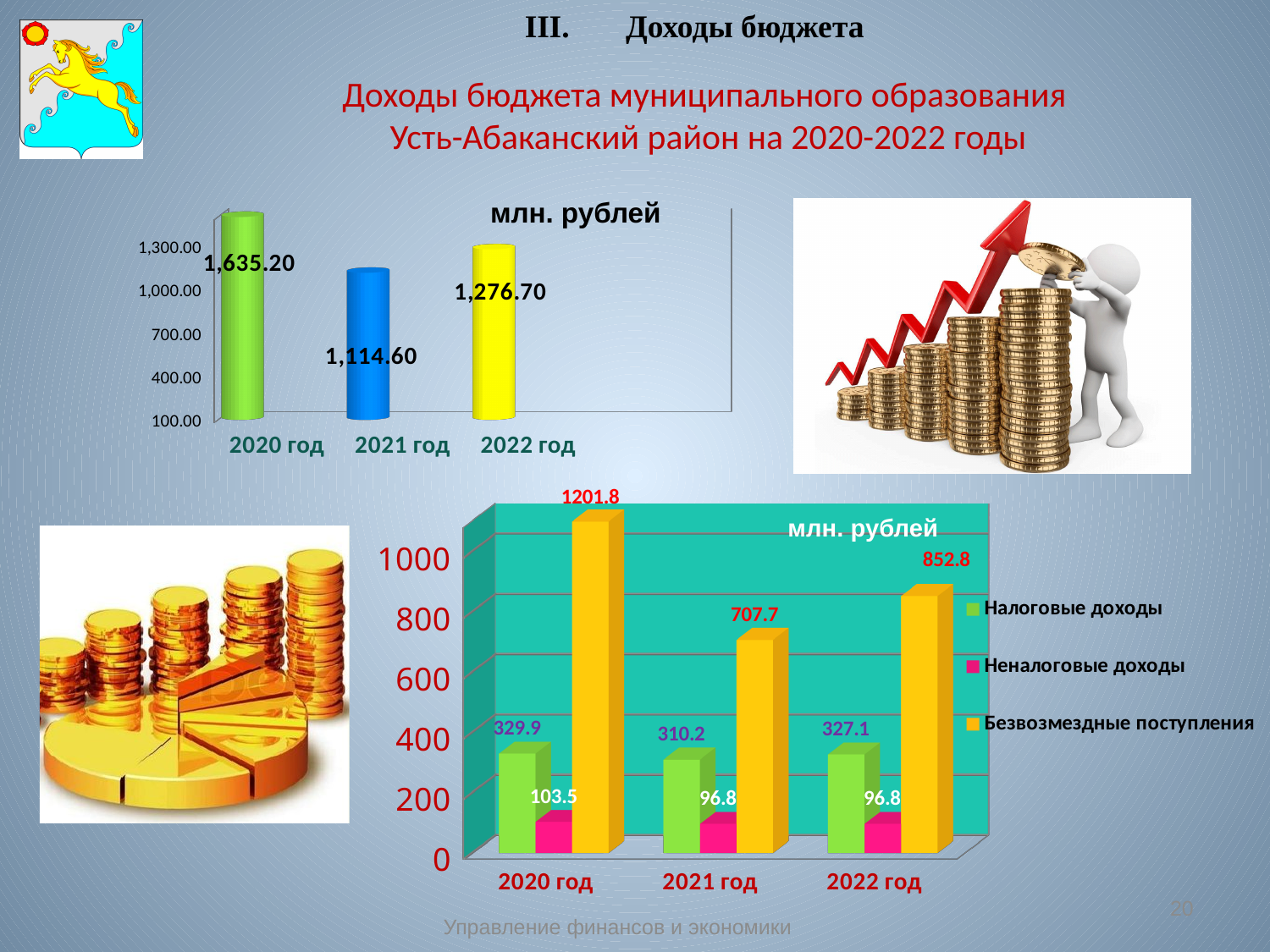
In the bottom chart, which is larger: Налоговые доходы for 2020 год or Налоговые доходы for 2021 год? 2020 год In the bottom chart, what is the value of Безвозмездные поступления for 2021 год? 707.7 In the top-left chart, what is the value for 2020 год? 1,635.20 What kind of chart is the bottom chart? Bar chart In the top-left chart, how many bars are plotted? 3 In the top-left chart, which year has the lowest value? 2021 год In the top-left chart, what is the difference between the values for 2020 год and 2022 год? 358.50 In the top-left chart, which year has the highest value? 2020 год In the top-left chart, what is the value for 2021 год? 1,114.60 In the bottom chart, which year has the highest value for Безвозмездные поступления? 2020 год In the bottom chart, how many series does the legend list? 3 In the bottom chart, what is the value of Налоговые доходы for 2022 год? 327.1